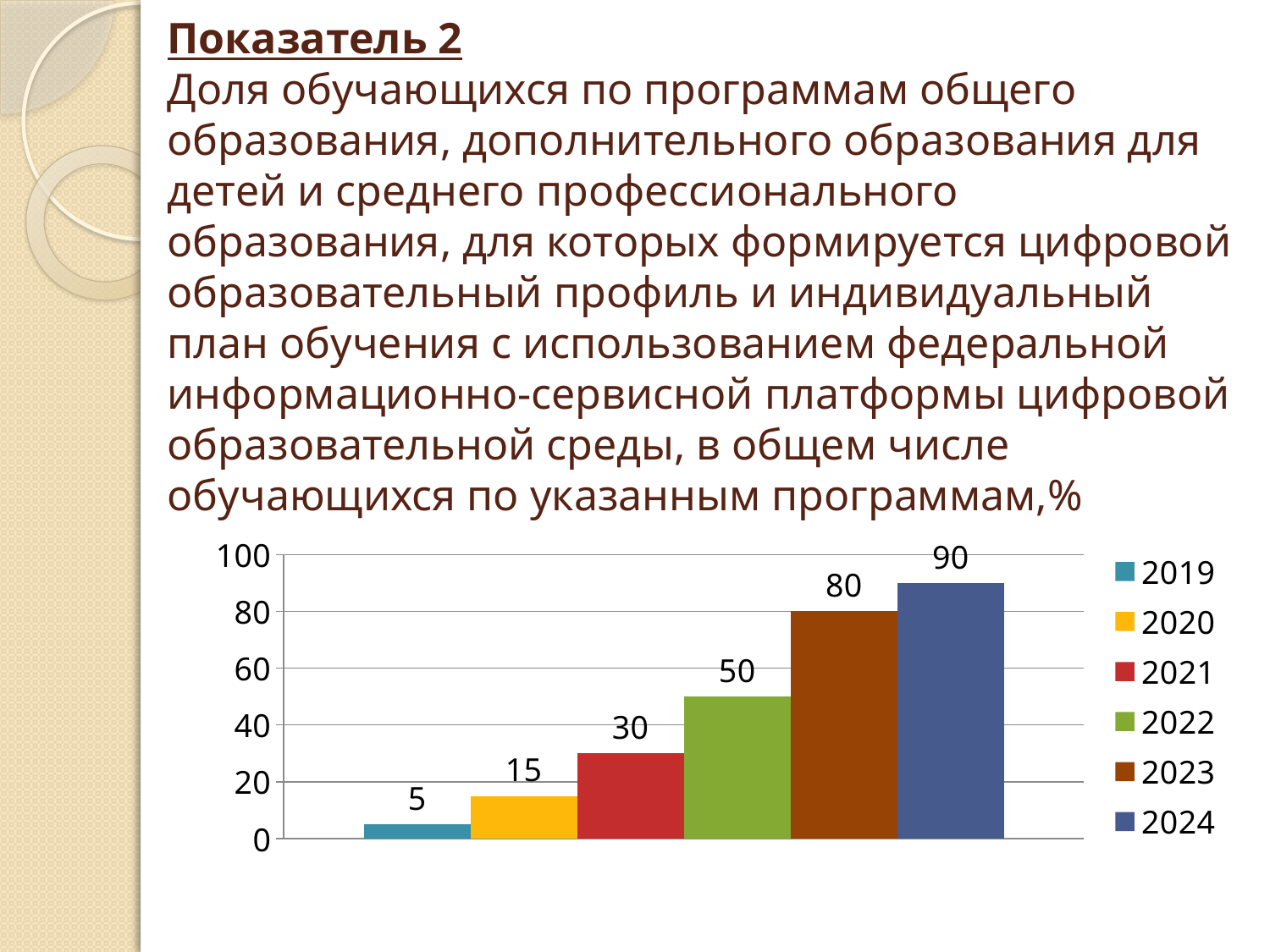
Which is larger, the value for 2020 or the value for 2021? 2021 What is the difference between the values for 2023 and 2021? 50 Is the value for 2023 greater or less than 60? greater What is the value for 2019? 5 How many bars are plotted in the chart? 6 Do the values rise or fall from 2019 to 2024? rise What is the value for 2024? 90 Which year has the highest value? 2024 What is the value for 2022? 50 What kind of chart is shown on the slide? bar chart How many entries does the legend list? 6 Which year has the lowest value? 2019